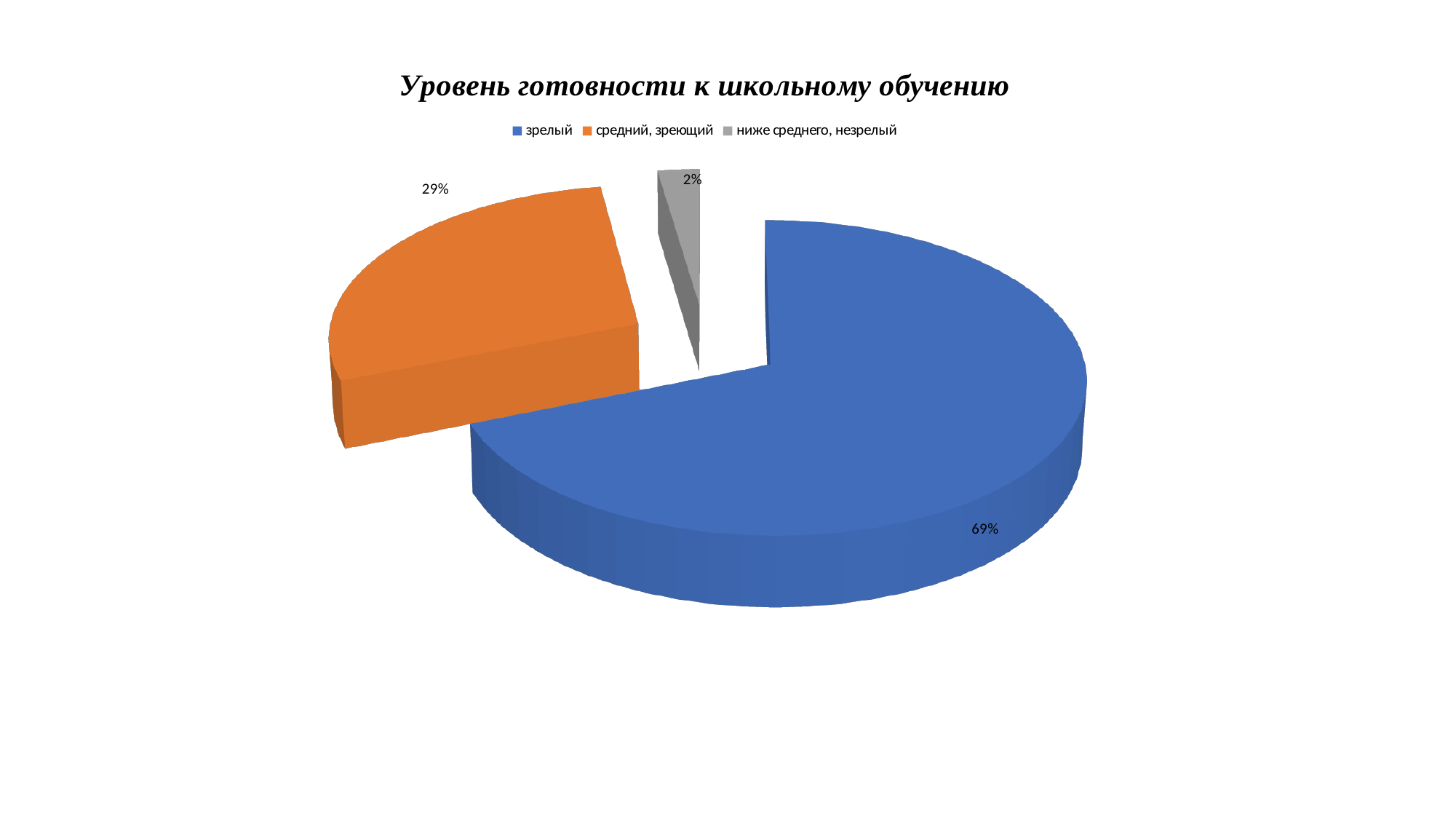
How many categories does the pie chart show? 3 Which is larger: the "средний, зреющий" slice or the "ниже среднего, незрелый" slice? средний, зреющий What is the difference in percentage points between the "зрелый" and "средний, зреющий" slices? 40 What kind of chart is shown on the slide? Pie chart What share of the pie does the "ниже среднего, незрелый" slice represent? 2% What share of the pie does the "средний, зреющий" slice represent? 29% Which category has the smallest slice of the pie? ниже среднего, незрелый What is the difference in percentage points between the "средний, зреющий" and "ниже среднего, незрелый" slices? 27 What is the title of the chart? Уровень готовности к школьному обучению What colour is the "средний, зреющий" slice? Orange Which category has the largest slice of the pie? зрелый What share of the pie does the "зрелый" slice represent? 69%